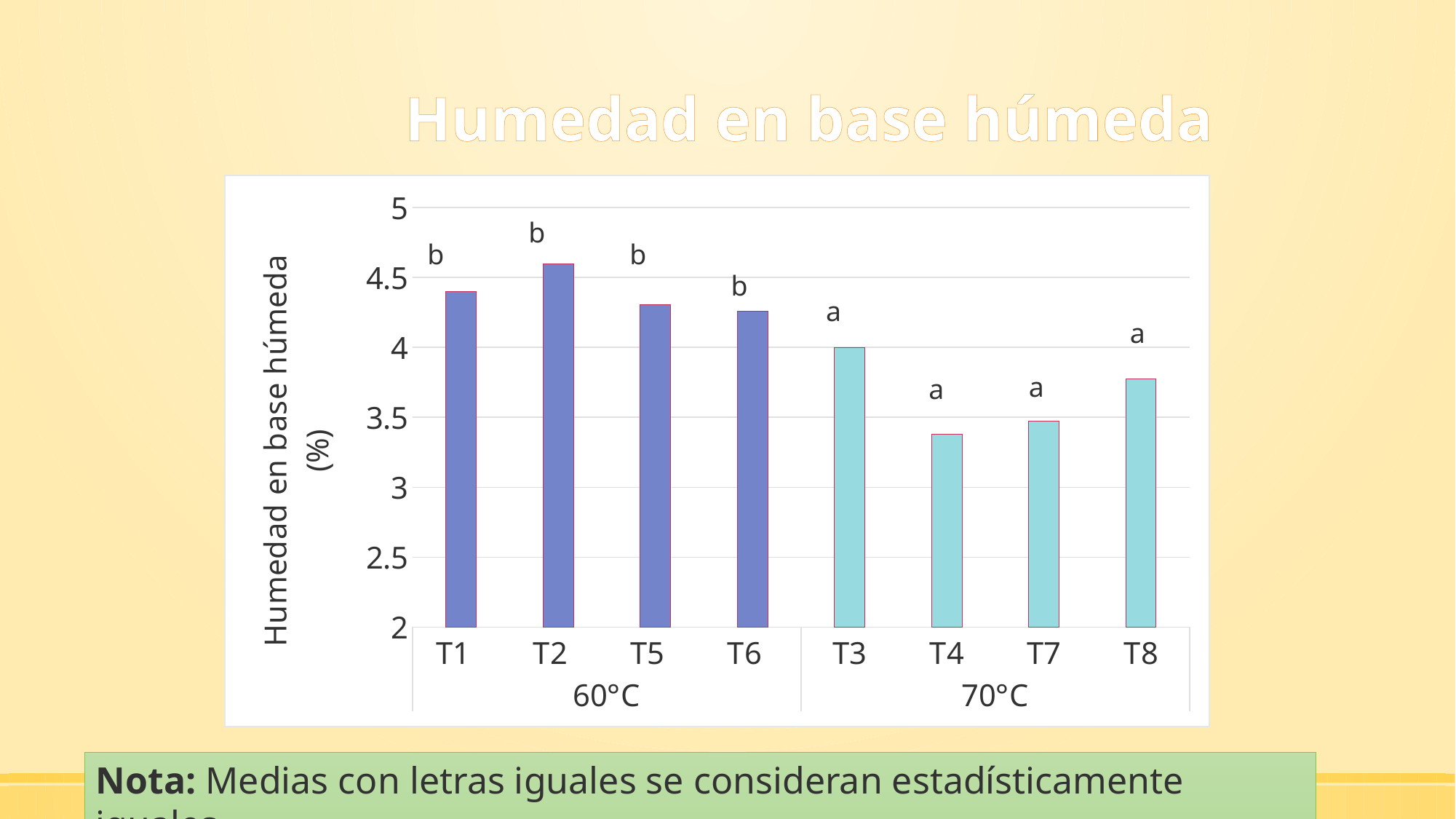
Is the value for T4 greater or less than 3.5? less Is the value for T2 greater or less than 4.5? greater Which has a larger value, T8 or T4? T8 Which treatment has the highest humidity value in the chart? T2 What is the title of the slide's chart? Humedad en base húmeda What kind of chart is shown on the slide? bar chart Is the value for T8 greater or less than 4? less Which has a larger value, T1 or T7? T1 How many treatment bars are plotted in the chart? 8 Which treatment has the lowest humidity value in the chart? T4 Which statistical letter is shown above the bars in the 70°C group? a